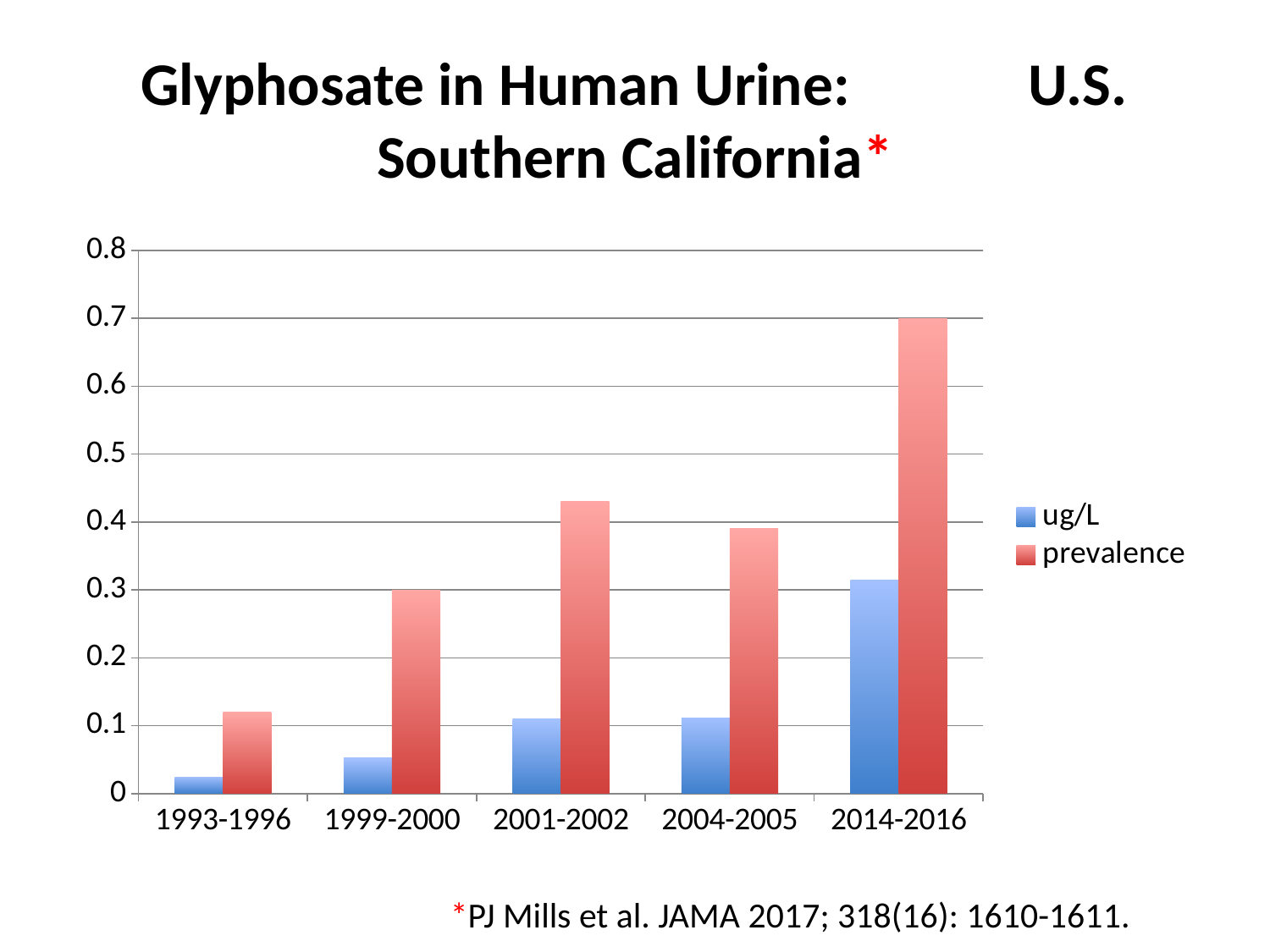
What is the prevalence value for 2014-2016? 0.7 Which time period has the lowest ug/L value? 1993-1996 Which series is shown in red in the legend? prevalence Which time period has the highest prevalence value? 2014-2016 What is the prevalence value for 1999-2000? 0.3 Which is larger, the prevalence value for 2001-2002 or for 2004-2005? 2001-2002 How many series does the legend list? 2 What kind of chart is shown on the slide? bar chart Is the prevalence value for 2001-2002 greater or less than 0.4? greater How many time-period categories are shown on the x axis? 5 Is the ug/L value for 2014-2016 greater or less than 0.3? greater Does the ug/L series generally rise or fall from 1993-1996 to 2014-2016? rise